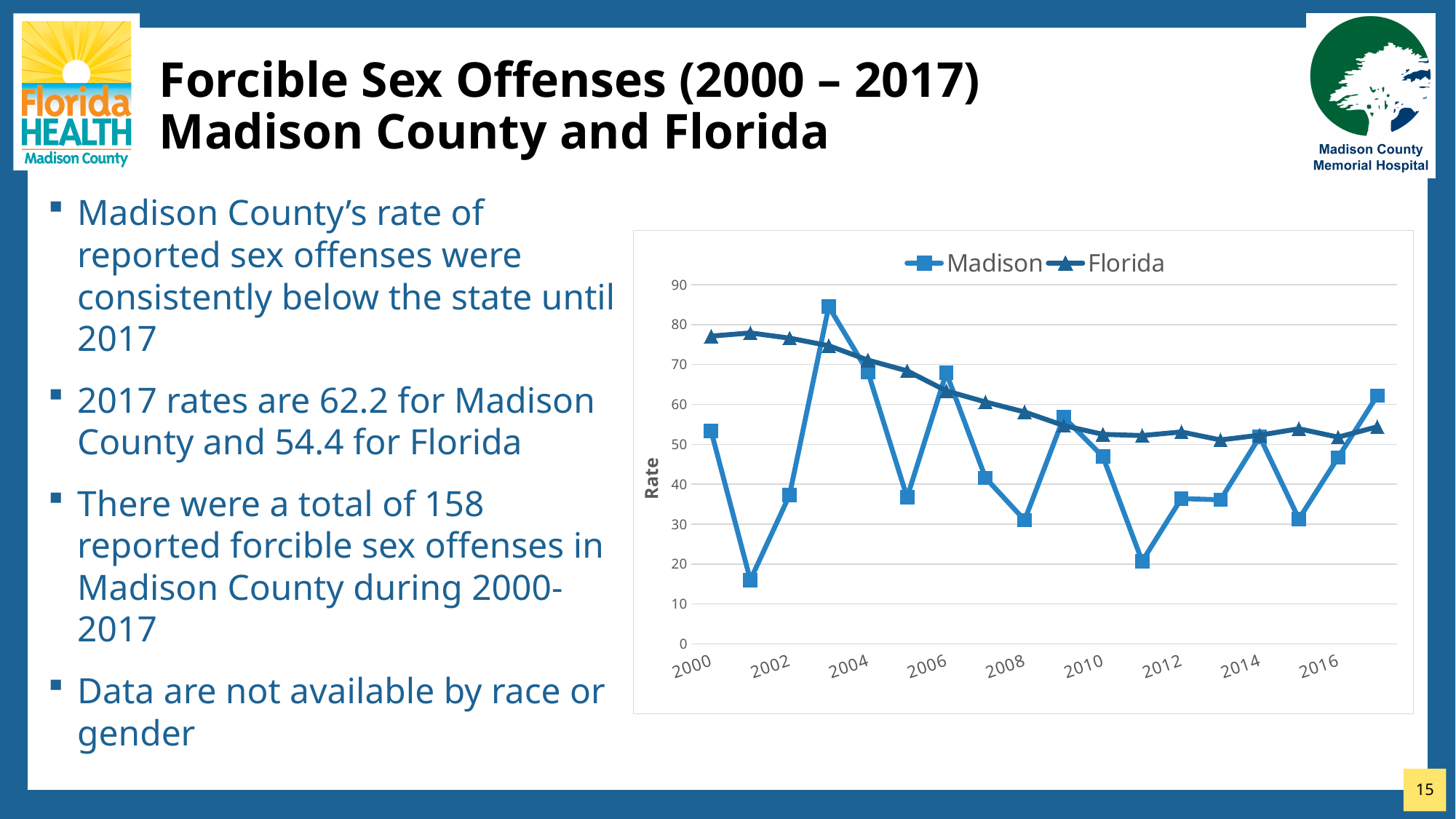
Which series are listed in the chart's legend? Madison and Florida Does the Florida series generally rise or fall from 2000 to 2017? fall Is the Madison value for 2001 greater or less than 20? less Is the Madison value for 2003 greater or less than 80? greater How many series does the chart's legend list? 2 How many years (data points per series) are plotted on the chart? 18 In which year does the Madison series reach its lowest value? 2001 What is the label on the vertical axis of the chart? Rate In which year does the Madison series reach its highest value? 2003 Is the Florida value for 2000 greater or less than 70? greater What kind of chart is shown on the slide? line chart Which series has the larger value in 2017, Madison or Florida? Madison